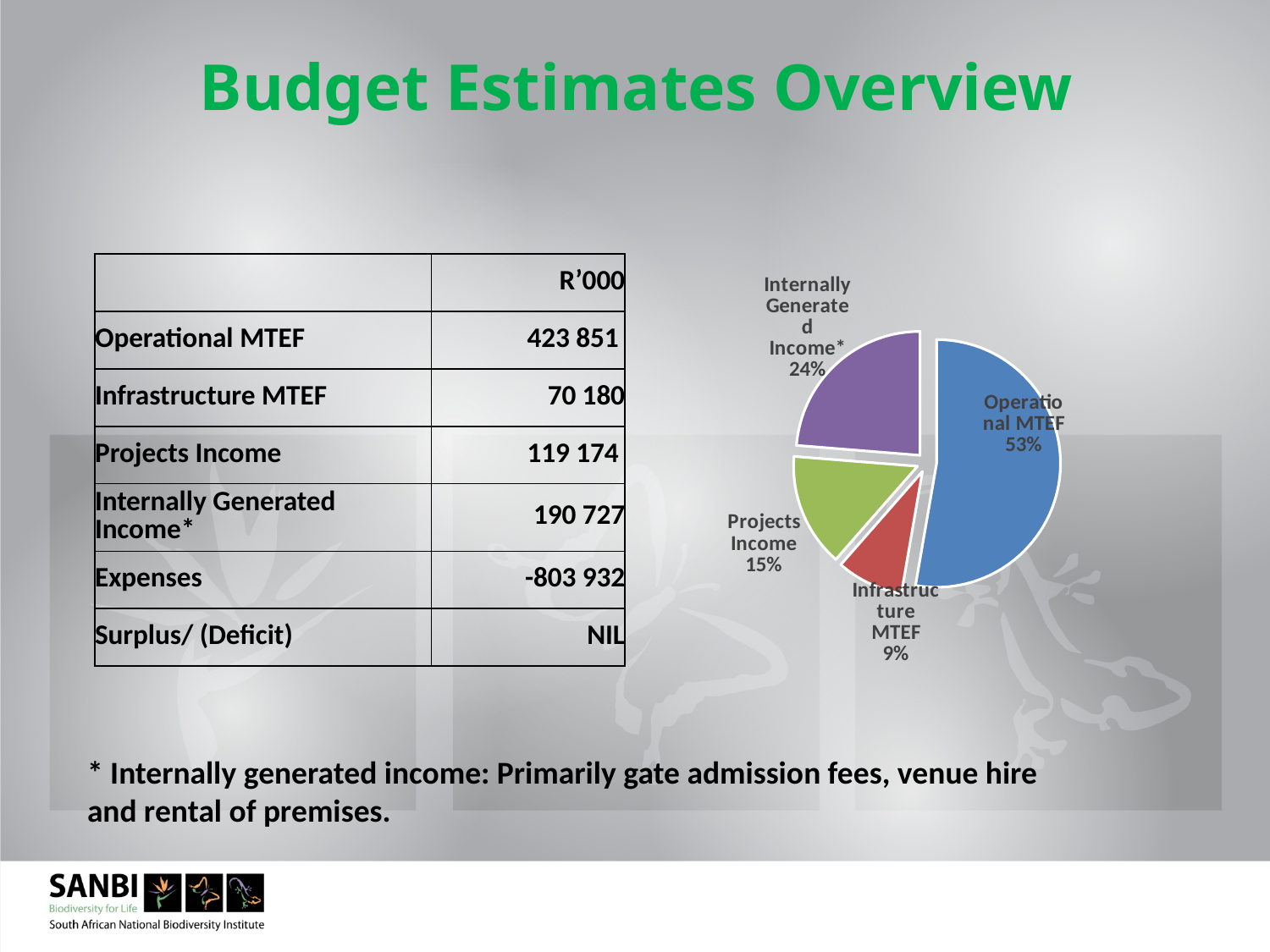
What share of the pie does Infrastructure MTEF represent? 9% What is the difference in percentage points between the Projects Income slice and the Infrastructure MTEF slice? 6 percentage points What colour is the Operational MTEF slice in the pie chart? blue What is the difference in percentage points between the Operational MTEF slice and the Internally Generated Income* slice? 29 percentage points What share of the pie does Operational MTEF represent? 53% Which is larger in the pie chart, Projects Income or Internally Generated Income*? Internally Generated Income* What kind of chart is shown on the slide? pie chart Which slice of the pie chart is the largest? Operational MTEF What share of the pie does Projects Income represent? 15% Which slice of the pie chart is the smallest? Infrastructure MTEF How many slices does the pie chart have? 4